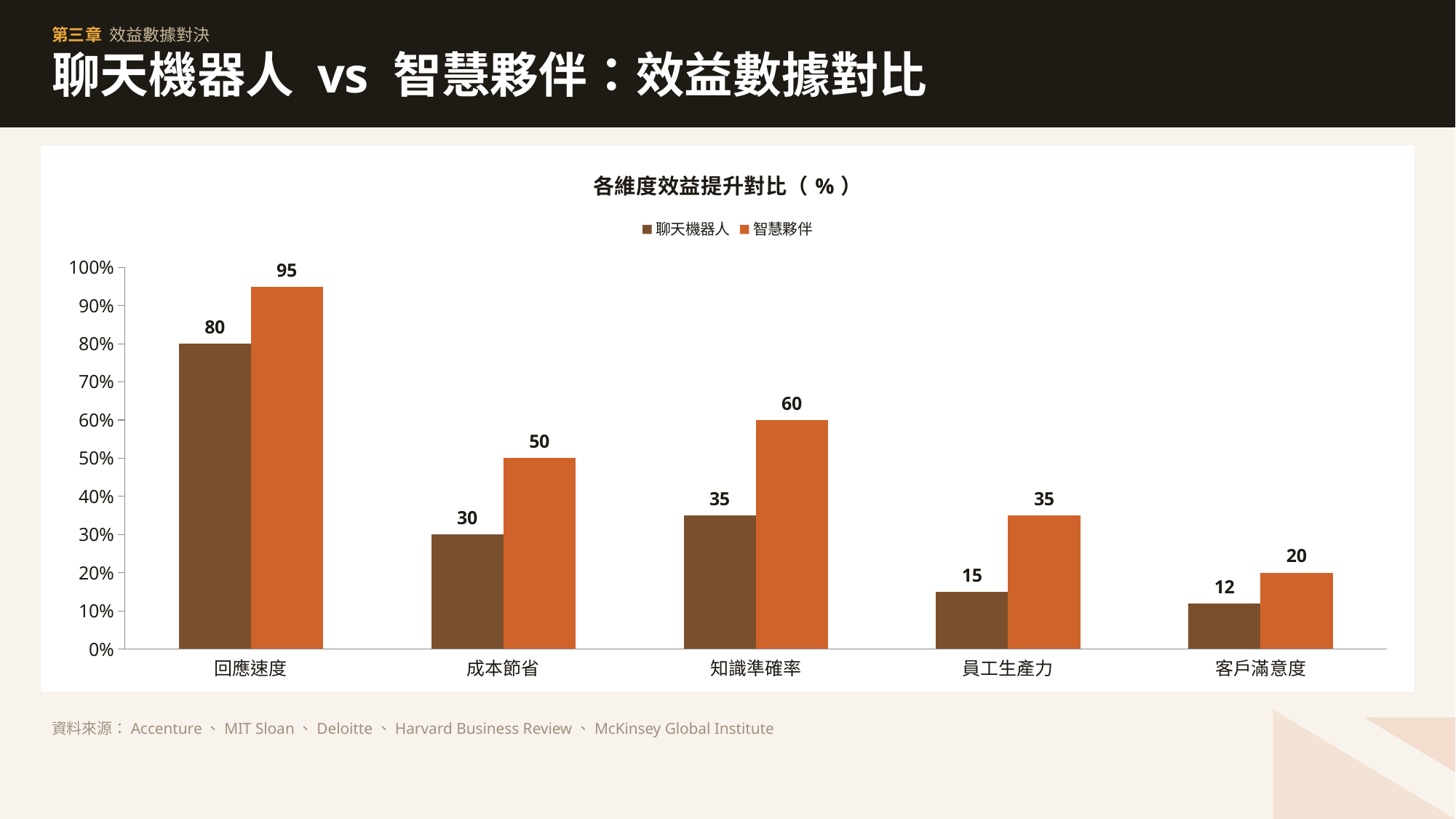
Which category has the highest value for 智慧夥伴? 回應速度 What is the difference between 智慧夥伴 and 聊天機器人 in the 成本節省 category? 20 Which category has the lowest value for 聊天機器人? 客戶滿意度 How many series does the legend list? 2 What is the value for 聊天機器人 in the 客戶滿意度 category? 12 How many categories are shown on the x axis? 5 What is the value for 聊天機器人 in the 知識準確率 category? 35 What is the title of the chart? 各維度效益提升對比（%） What kind of chart is shown on the slide? Bar chart What is the difference between 智慧夥伴 and 聊天機器人 in the 知識準確率 category? 25 What is the value for 智慧夥伴 in the 回應速度 category? 95 Which is larger: 聊天機器人 for 員工生產力 or 智慧夥伴 for 客戶滿意度? 智慧夥伴 for 客戶滿意度